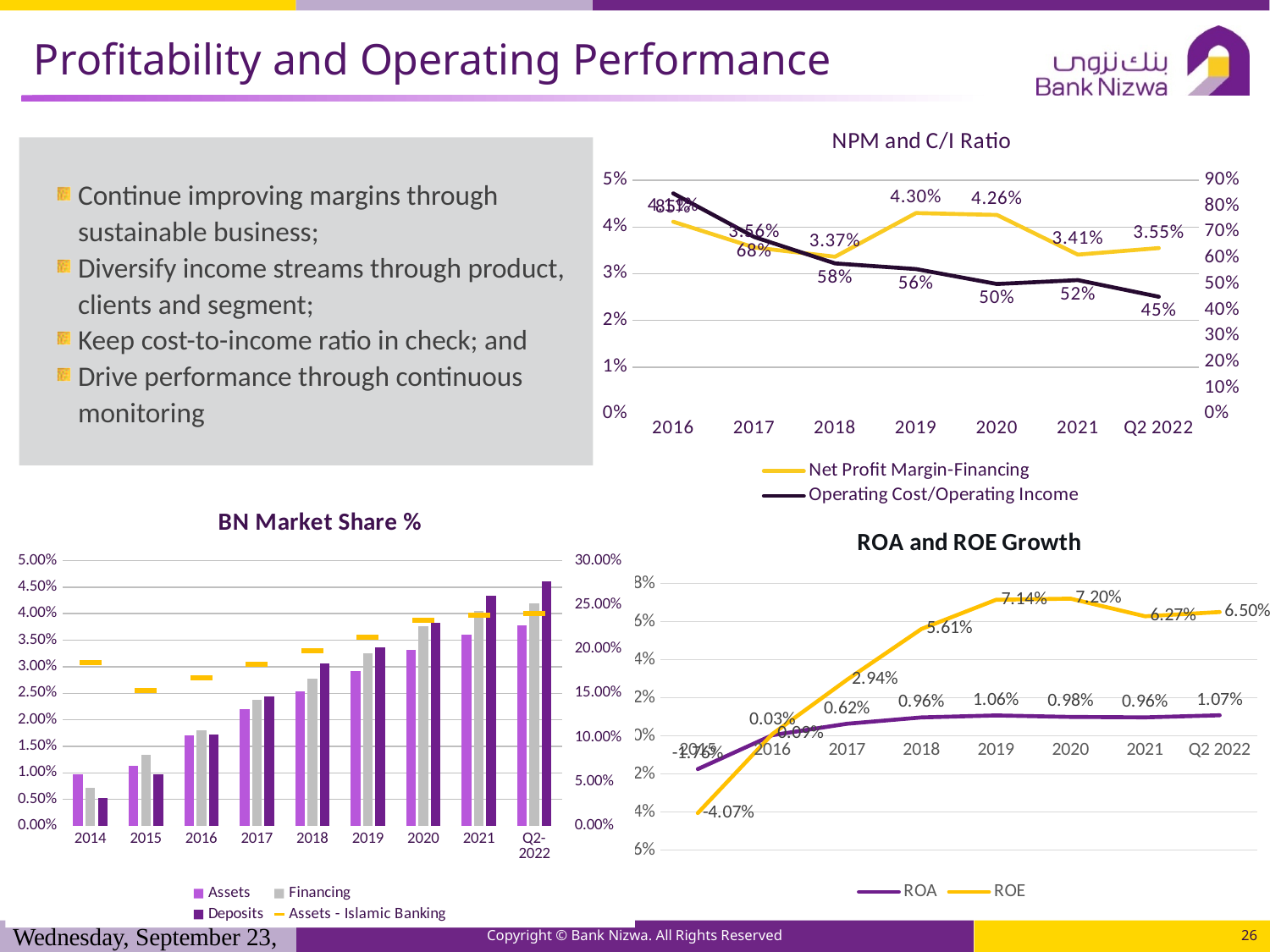
In the ROA and ROE Growth chart, what is the ROE value for 2020? 7.20% In the NPM and C/I Ratio chart, what is the Net Profit Margin-Financing value for 2019? 4.30% How many series does the legend of the NPM and C/I Ratio chart list? 2 In the NPM and C/I Ratio chart, in which year is Net Profit Margin-Financing highest? 2019 How many categories are shown on the x axis of the BN Market Share % chart? 9 In the ROA and ROE Growth chart, in which year is ROE lowest? 2015 In the ROA and ROE Growth chart, what is the ROA value for Q2 2022? 1.07% What kind of chart is the BN Market Share % chart? combination bar and line chart In the NPM and C/I Ratio chart, does the Operating Cost/Operating Income line generally rise or fall from 2016 to Q2 2022? fall In the NPM and C/I Ratio chart, what is the Operating Cost/Operating Income value for Q2 2022? 45% In the NPM and C/I Ratio chart, what is the difference between the Net Profit Margin-Financing values for 2019 and 2018? 0.93% In the BN Market Share % chart, is the Deposits value for Q2-2022 greater or less than 4.00%? greater